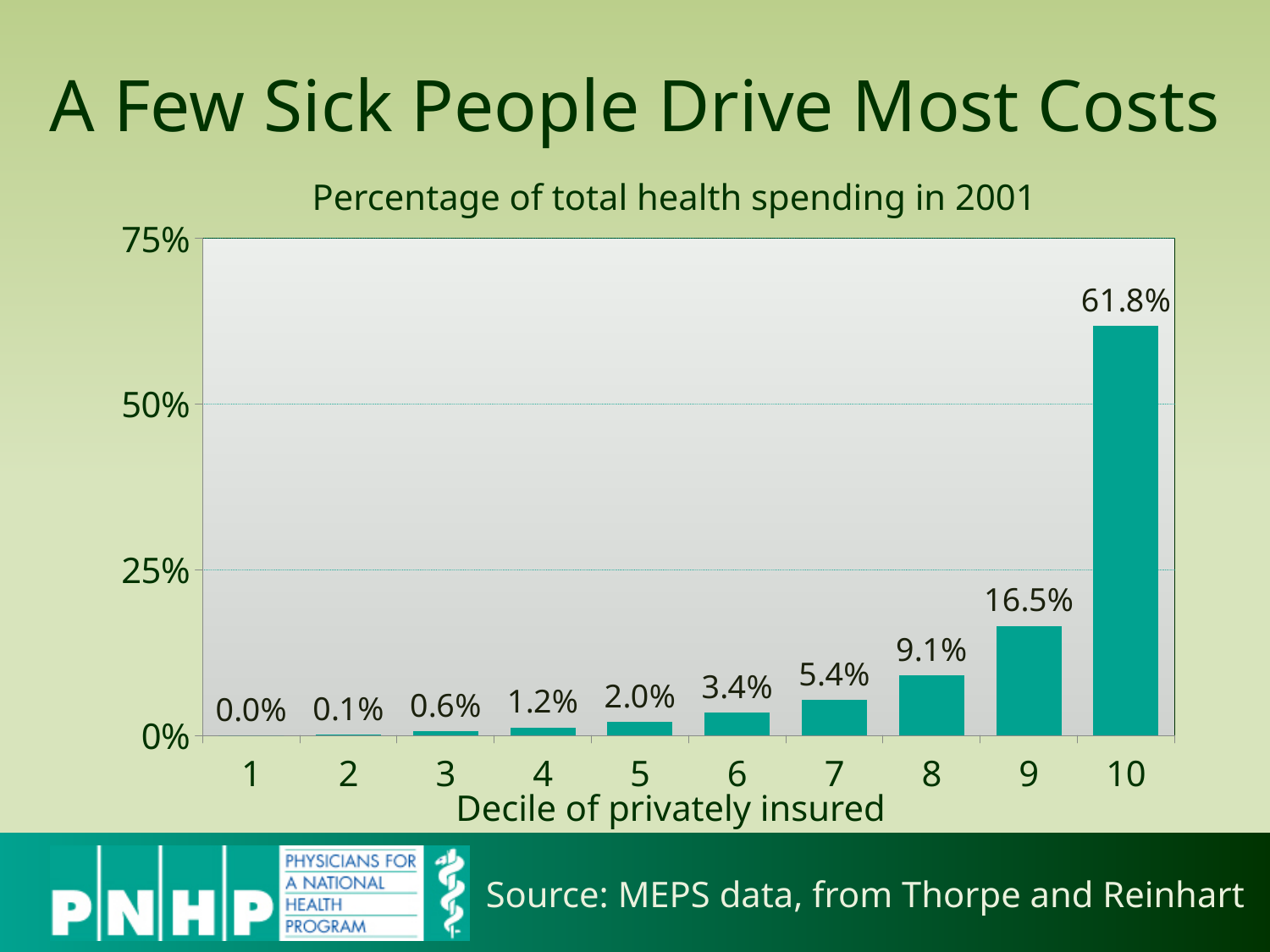
What is the difference between the values for decile 10 and decile 9? 45.3% Which has a larger share of spending, decile 8 or decile 6? Decile 8 Which decile has the highest percentage of total health spending? 10 What percentage of total health spending is attributed to decile 10? 61.8% Do the values rise or fall as the decile number increases from 1 to 10? Rise How many deciles are shown on the x axis? 10 What kind of chart is shown on the slide? Bar chart What is the x-axis label of the chart? Decile of privately insured Which decile has the lowest percentage of total health spending? 1 What is the value shown for decile 9? 16.5% What percentage of total health spending does decile 7 account for? 5.4% Is the value for decile 10 greater or less than 50%? greater